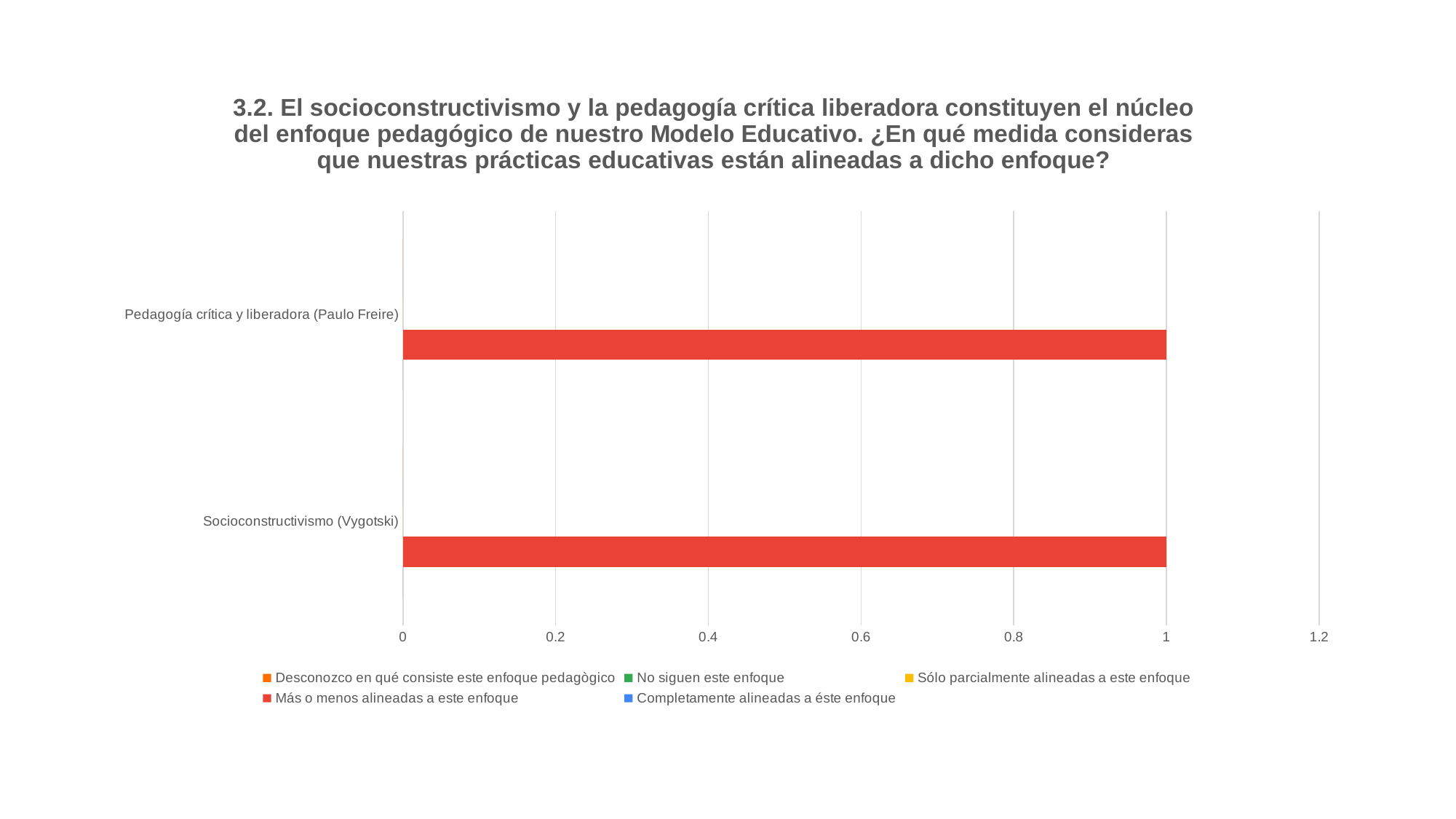
What is the value of the 'Más o menos alineadas a este enfoque' bar for 'Socioconstructivismo (Vygotski)'? 1 Is the value of the bar for 'Socioconstructivismo (Vygotski)' greater or less than 0.8? greater What is the value of the 'Más o menos alineadas a este enfoque' bar for 'Pedagogía crítica y liberadora (Paulo Freire)'? 1 How many categories are plotted on the vertical axis of the chart? 2 Is the value of the bar for 'Pedagogía crítica y liberadora (Paulo Freire)' greater or less than 0.6? greater What is the difference between the bar values for 'Pedagogía crítica y liberadora (Paulo Freire)' and 'Socioconstructivismo (Vygotski)'? 0 Which legend series do the visible red bars in the chart belong to? Más o menos alineadas a este enfoque What kind of chart is shown on the slide? bar chart How many series does the chart's legend list? 5 What is the highest tick value shown on the horizontal axis of the chart? 1.2